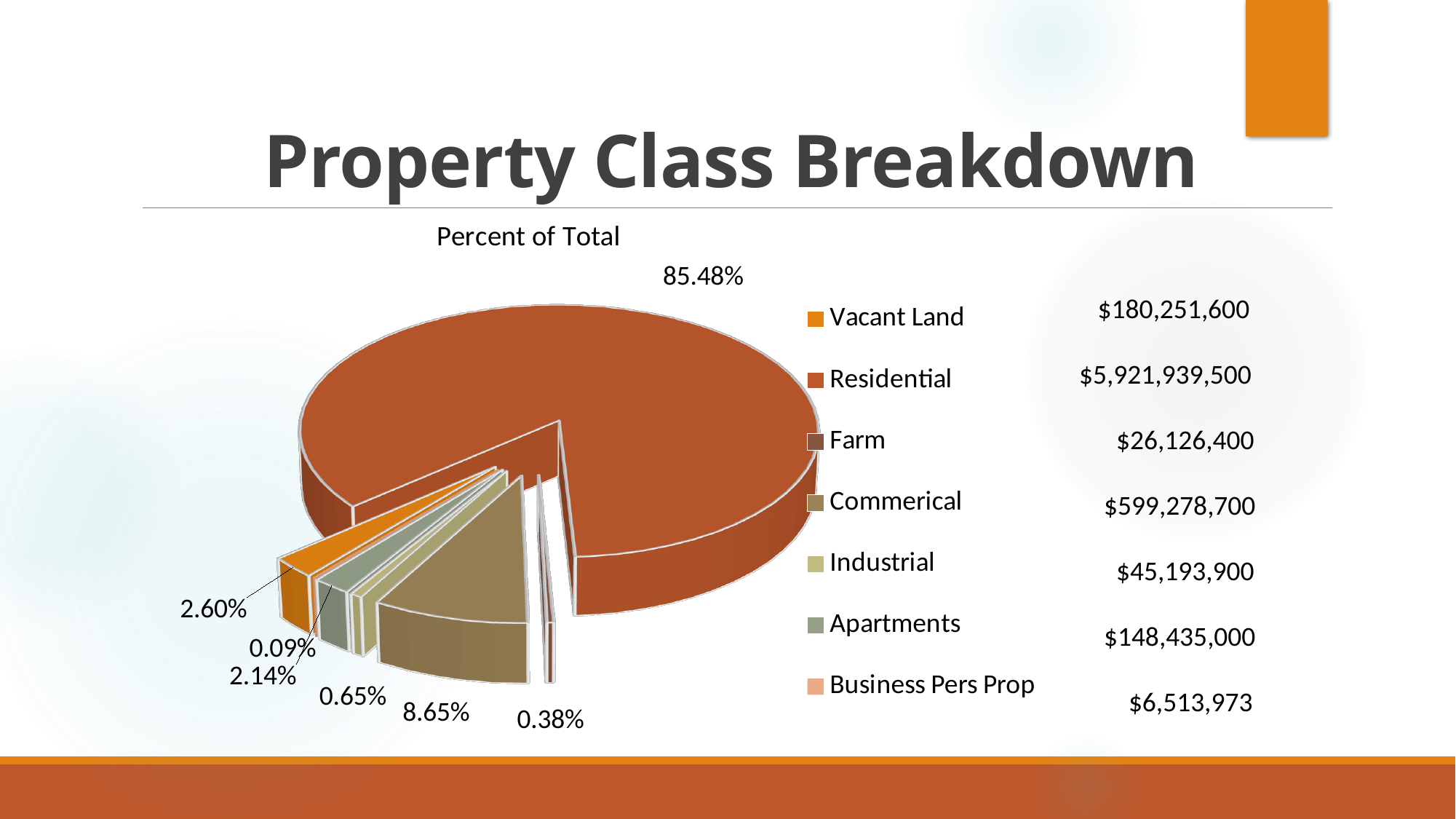
What colour represents Vacant Land in the pie chart's legend? orange Which property class has the smallest slice of the pie chart? Business Pers Prop How many property classes does the pie chart's legend list? 7 What percentage of the total does Vacant Land account for in the pie chart? 2.60% Which is larger in the pie chart, the Residential share or the Commerical share? Residential What percentage of the total does Residential account for in the pie chart? 85.48% What dollar value is listed next to Residential on the slide? $5,921,939,500 Which property class has the largest slice of the pie chart? Residential What kind of chart is shown on the slide? pie chart By how many percentage points does the Residential share exceed the Commerical share? 76.83% What is the title of the pie chart? Percent of Total What percentage of the total does Commerical account for in the pie chart? 8.65%